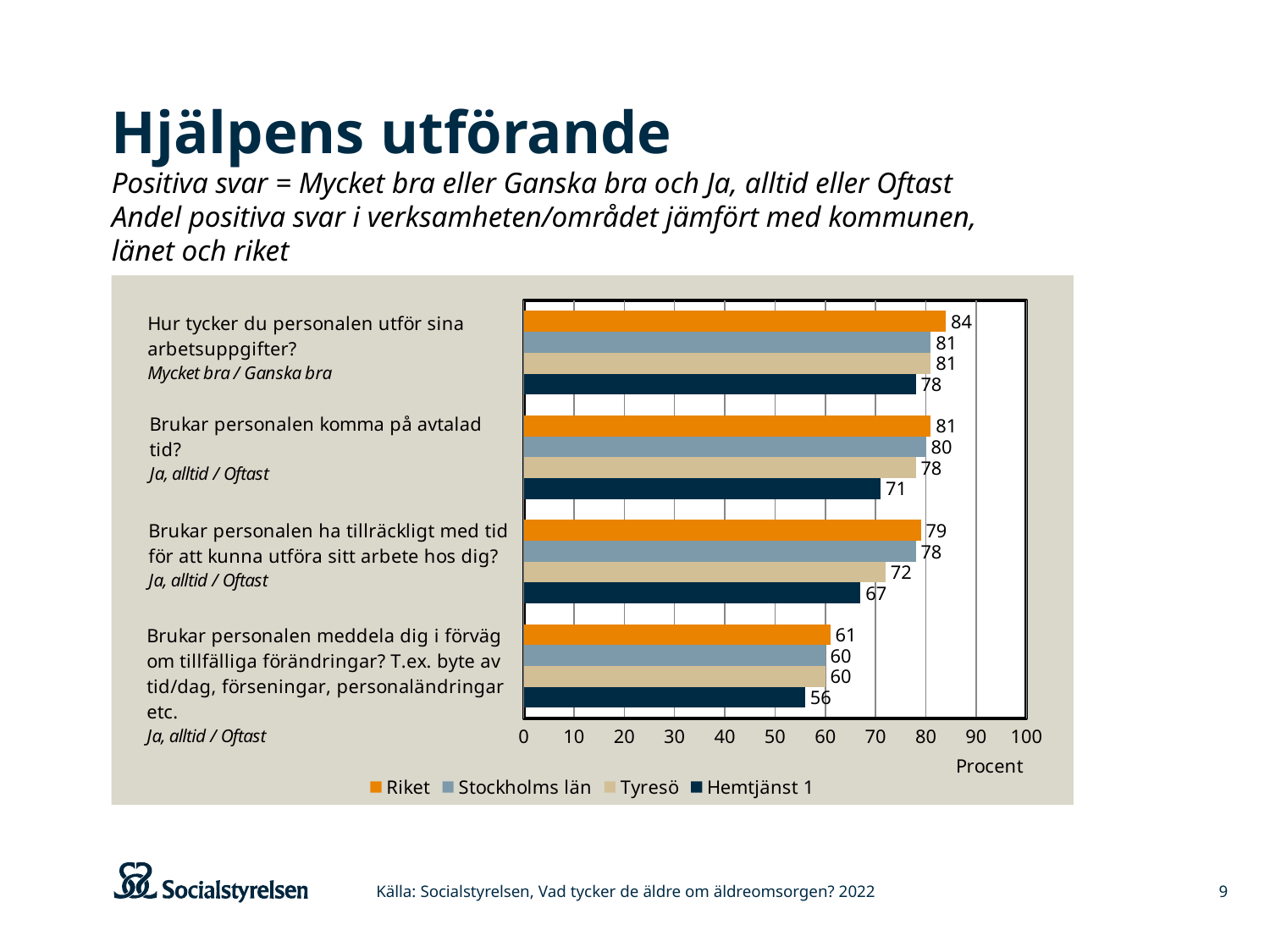
What is the difference between Riket and Hemtjänst 1 on the question "Brukar personalen ha tillräckligt med tid för att kunna utföra sitt arbete hos dig?"? 12 What is the value for Riket on the question "Hur tycker du personalen utför sina arbetsuppgifter?"? 84 What is the value for Tyresö on the question "Brukar personalen ha tillräckligt med tid för att kunna utföra sitt arbete hos dig?"? 72 Which series has the highest value on the question "Brukar personalen ha tillräckligt med tid för att kunna utföra sitt arbete hos dig?"? Riket Is the value for Hemtjänst 1 on the question "Brukar personalen meddela dig i förväg om tillfälliga förändringar?" greater or less than 60? less What is the label of the horizontal axis of the chart? Procent How many series does the legend list? 4 How many questions (categories) are shown in the chart? 4 What is the value for Hemtjänst 1 on the question "Brukar personalen komma på avtalad tid?"? 71 Which series has the lowest value on the question "Brukar personalen meddela dig i förväg om tillfälliga förändringar?"? Hemtjänst 1 Which is larger on the question "Brukar personalen komma på avtalad tid?": Stockholms län or Hemtjänst 1? Stockholms län What kind of chart is shown on the slide? Bar chart